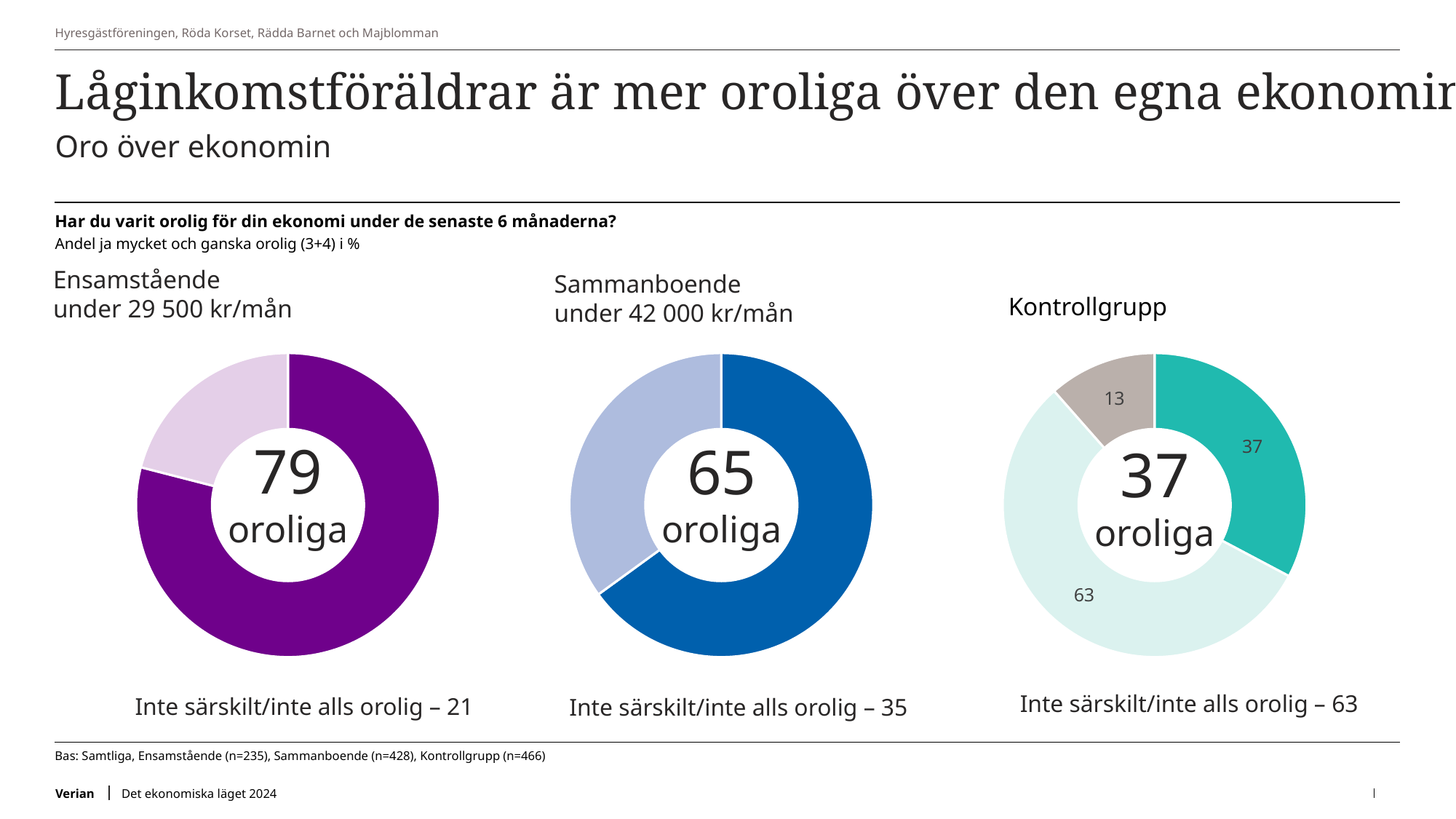
Which group has a larger oroliga share, Sammanboende or Kontrollgrupp? Sammanboende Which of the three groups has the lowest share of oroliga? Kontrollgrupp What kind of chart is used for each of the three groups on the slide? Donut (pie) chart In the Kontrollgrupp chart, what value is given for Inte särskilt/inte alls orolig? 63 In the Sammanboende under 42 000 kr/mån chart, what share is shown as oroliga? 65 In the Kontrollgrupp chart, what share is shown as oroliga? 37 In the Ensamstående under 29 500 kr/mån chart, what share is shown as oroliga? 79 What is the difference between the oroliga share for Ensamstående and for Kontrollgrupp? 42 In the Sammanboende chart, what value is given for Inte särskilt/inte alls orolig? 35 Which of the three groups has the highest share of oroliga? Ensamstående under 29 500 kr/mån How many donut charts are shown on the slide? 3 In the Ensamstående chart, what value is given for Inte särskilt/inte alls orolig? 21